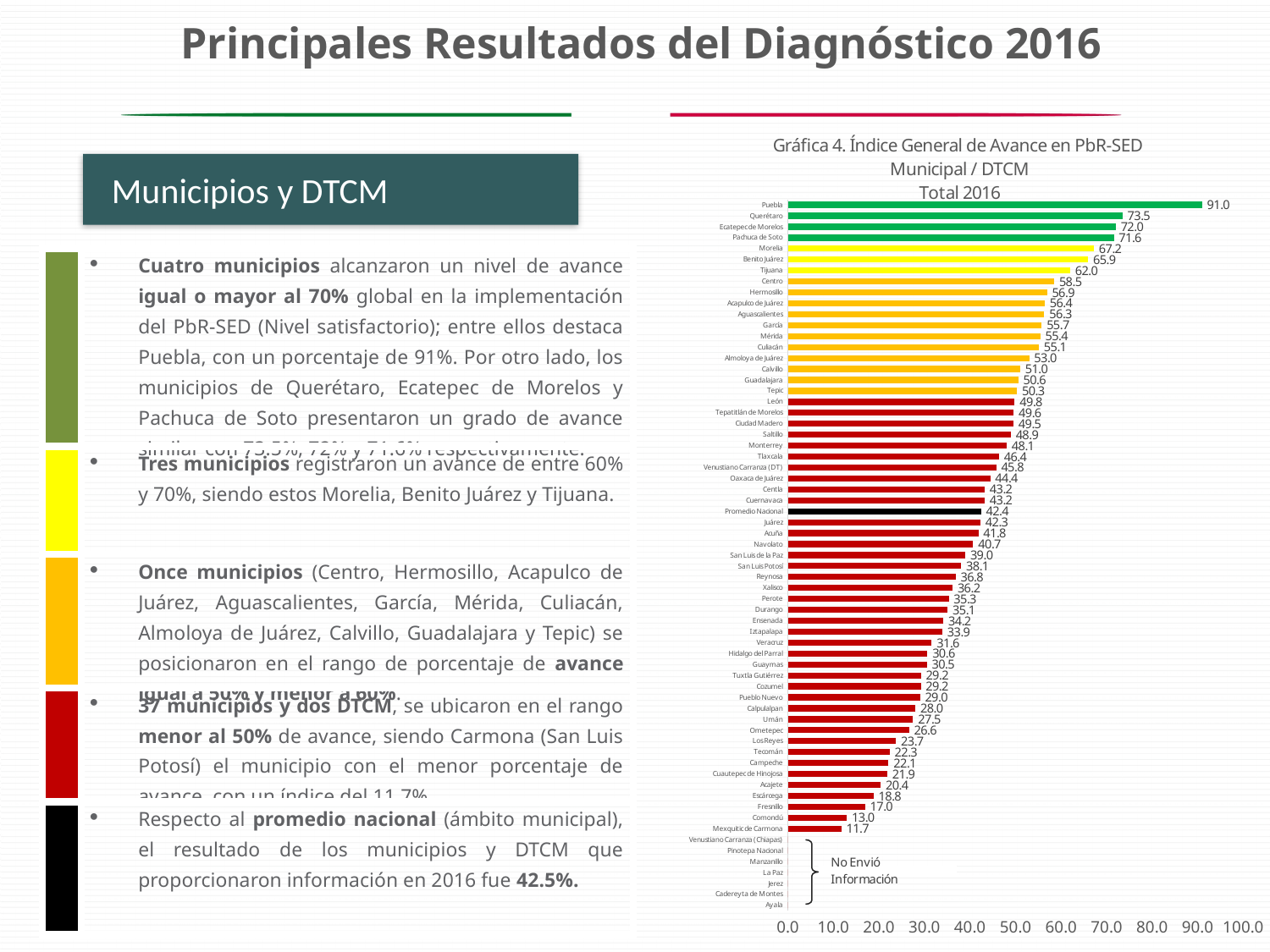
What is the value for Mexquitic de Carmona in the chart? 11.7 Which has a larger value, Morelia or Tijuana? Morelia Is the value for Guadalajara greater or less than 50.0? greater What is the value for Puebla in the chart? 91.0 Which municipality has the highest value in the chart? Puebla What is the value for Querétaro in the chart? 73.5 What is the difference between the values for Puebla and Querétaro? 17.5 What is the title of the chart? Gráfica 4. Índice General de Avance en PbR-SED Municipal / DTCM Total 2016 What is the difference between the values for Ecatepec de Morelos and Pachuca de Soto? 0.4 What is the value for Promedio Nacional in the chart? 42.4 Among the municipalities with a plotted value, which has the lowest value? Mexquitic de Carmona What type of chart is shown on the slide? bar chart